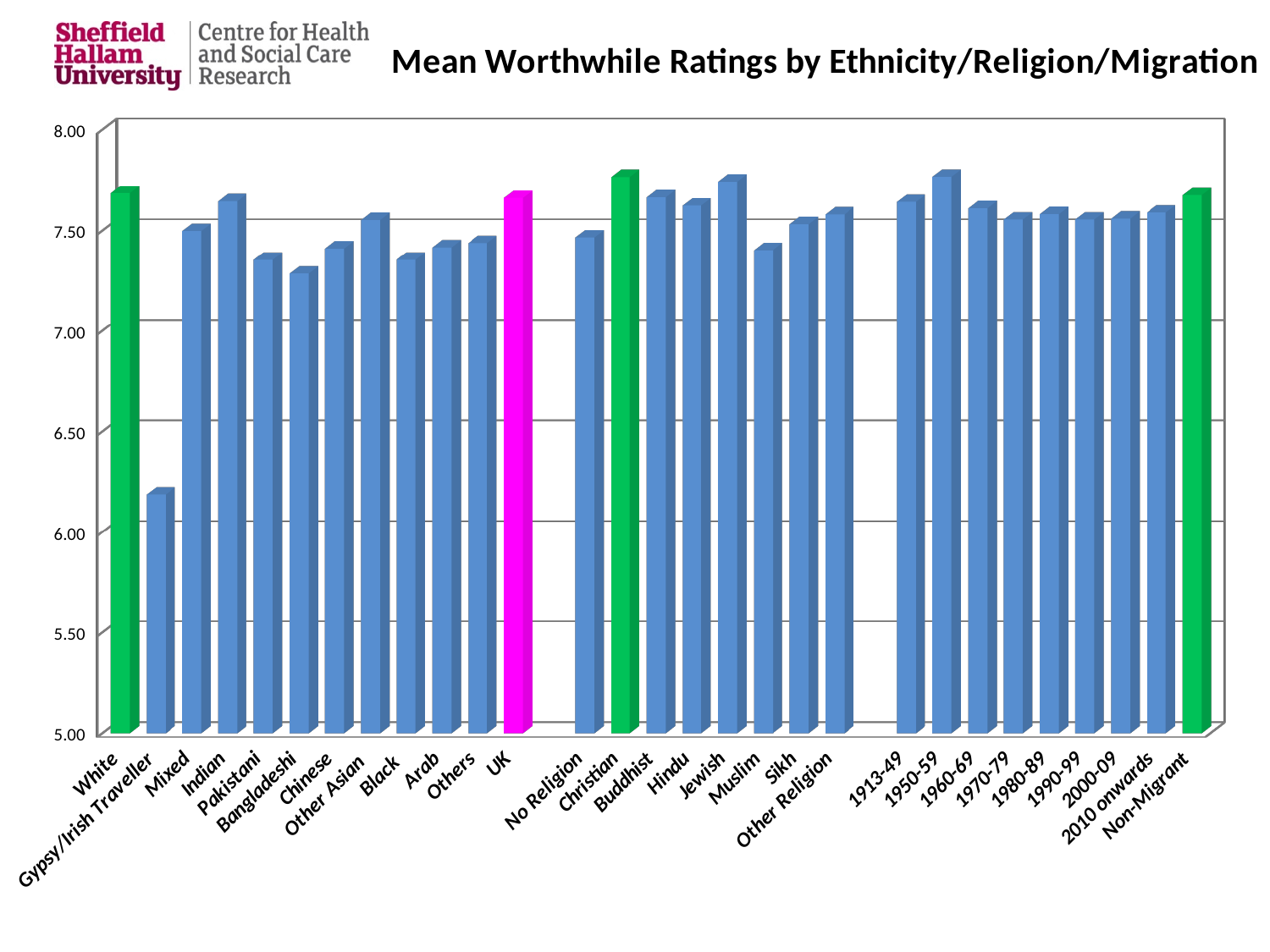
Is the value for Muslim greater or less than 7.50? less Which has the higher mean worthwhile rating, Indian or Bangladeshi? Indian Which has the higher mean worthwhile rating, Jewish or Muslim? Jewish What kind of chart is shown on the slide? bar chart Is the value for Gypsy/Irish Traveller greater or less than 6.00? greater Is the value for White greater or less than 7.50? greater What is the title of the chart? Mean Worthwhile Ratings by Ethnicity/Religion/Migration What colour is the bar for UK? magenta Which has the higher mean worthwhile rating, Mixed or Gypsy/Irish Traveller? Mixed Which category has the lowest mean worthwhile rating? Gypsy/Irish Traveller